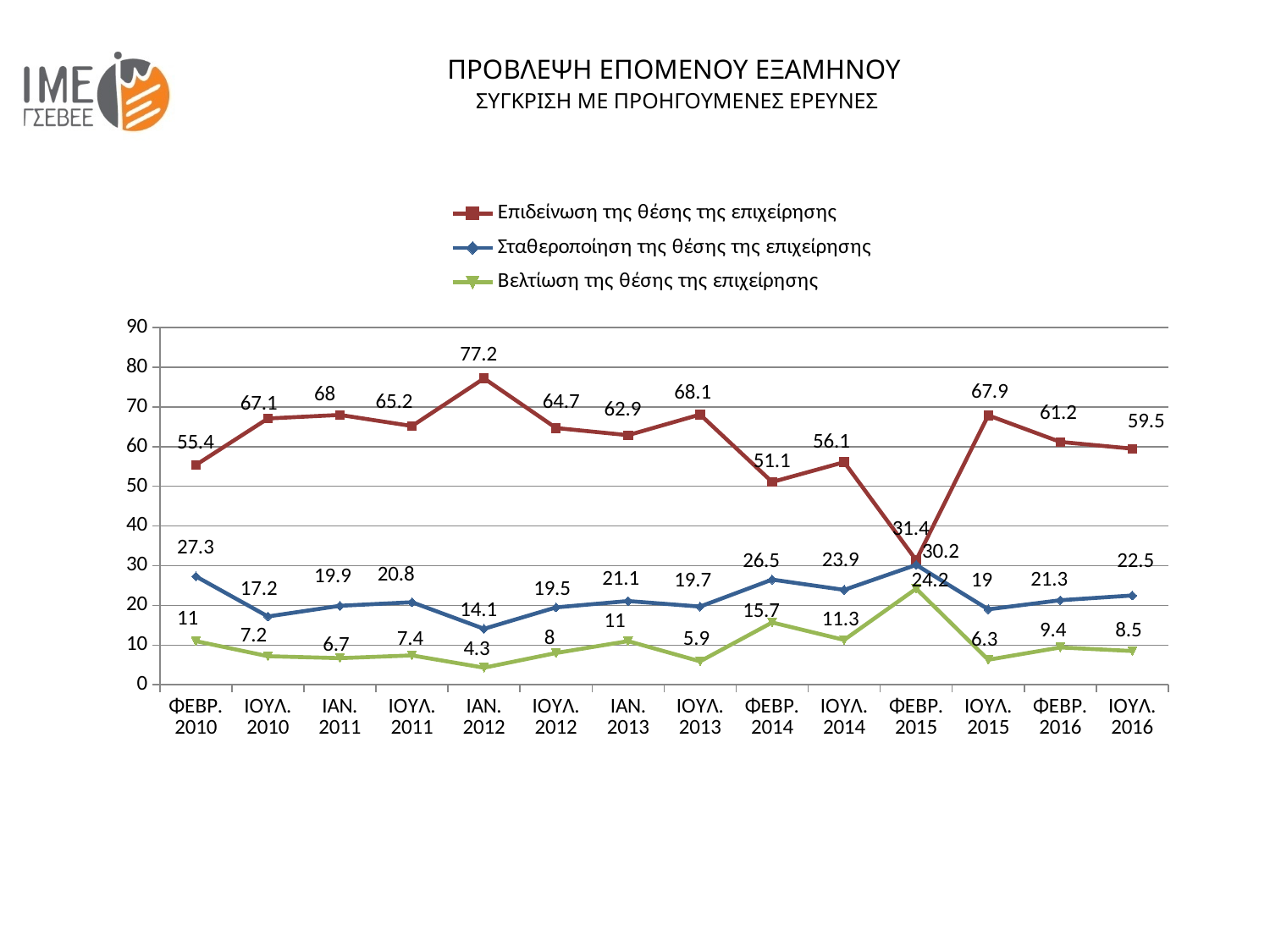
In which period does Επιδείνωση της θέσης της επιχείρησης reach its highest value? ΙΑΝ. 2012 What kind of chart is shown on the slide? line chart What is the difference between Επιδείνωση and Σταθεροποίηση της θέσης της επιχείρησης in ΙΟΥΛ. 2016? 37 How many series does the legend list? 3 What is the value of Βελτίωση της θέσης της επιχείρησης for ΦΕΒΡ. 2014? 15.7 What is the main title of the chart? ΠΡΟΒΛΕΨΗ ΕΠΟΜΕΝΟΥ ΕΞΑΜΗΝΟΥ How many survey periods are shown along the x axis? 14 In which period is Βελτίωση της θέσης της επιχείρησης at its lowest? ΙΑΝ. 2012 Which is larger for Σταθεροποίηση της θέσης της επιχείρησης: ΦΕΒΡ. 2010 or ΙΟΥΛ. 2010? ΦΕΒΡ. 2010 What is the value of Επιδείνωση της θέσης της επιχείρησης for ΙΑΝ. 2012? 77.2 Is the value of Επιδείνωση της θέσης της επιχείρησης for ΙΟΥΛ. 2015 greater or less than 60? greater What is the value of Σταθεροποίηση της θέσης της επιχείρησης for ΙΑΝ. 2013? 21.1